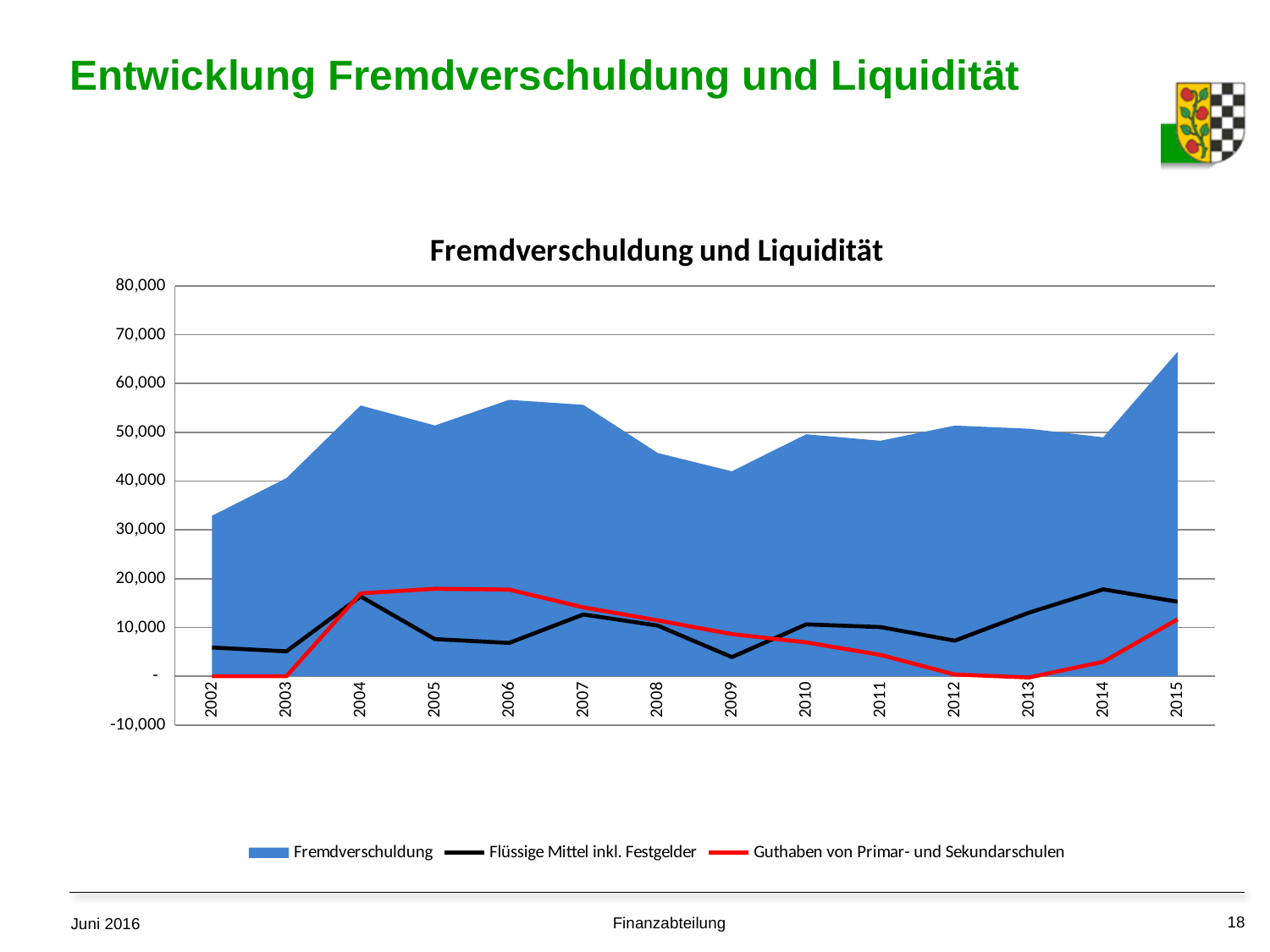
How many years are shown on the x axis? 14 Does Guthaben von Primar- und Sekundarschulen rise or fall from 2006 to 2013? fall In 2014, which is larger: Flüssige Mittel inkl. Festgelder or Guthaben von Primar- und Sekundarschulen? Flüssige Mittel inkl. Festgelder What is the title of the chart? Fremdverschuldung und Liquidität In which year is Fremdverschuldung lowest? 2002 How many series does the legend list? 3 Is the Flüssige Mittel inkl. Festgelder value for 2009 greater or less than 10,000? less Is the Fremdverschuldung value for 2002 greater or less than 40,000? less Is the Fremdverschuldung value for 2015 greater or less than 60,000? greater In which year is Fremdverschuldung highest? 2015 What colour is used for the Fremdverschuldung series? blue